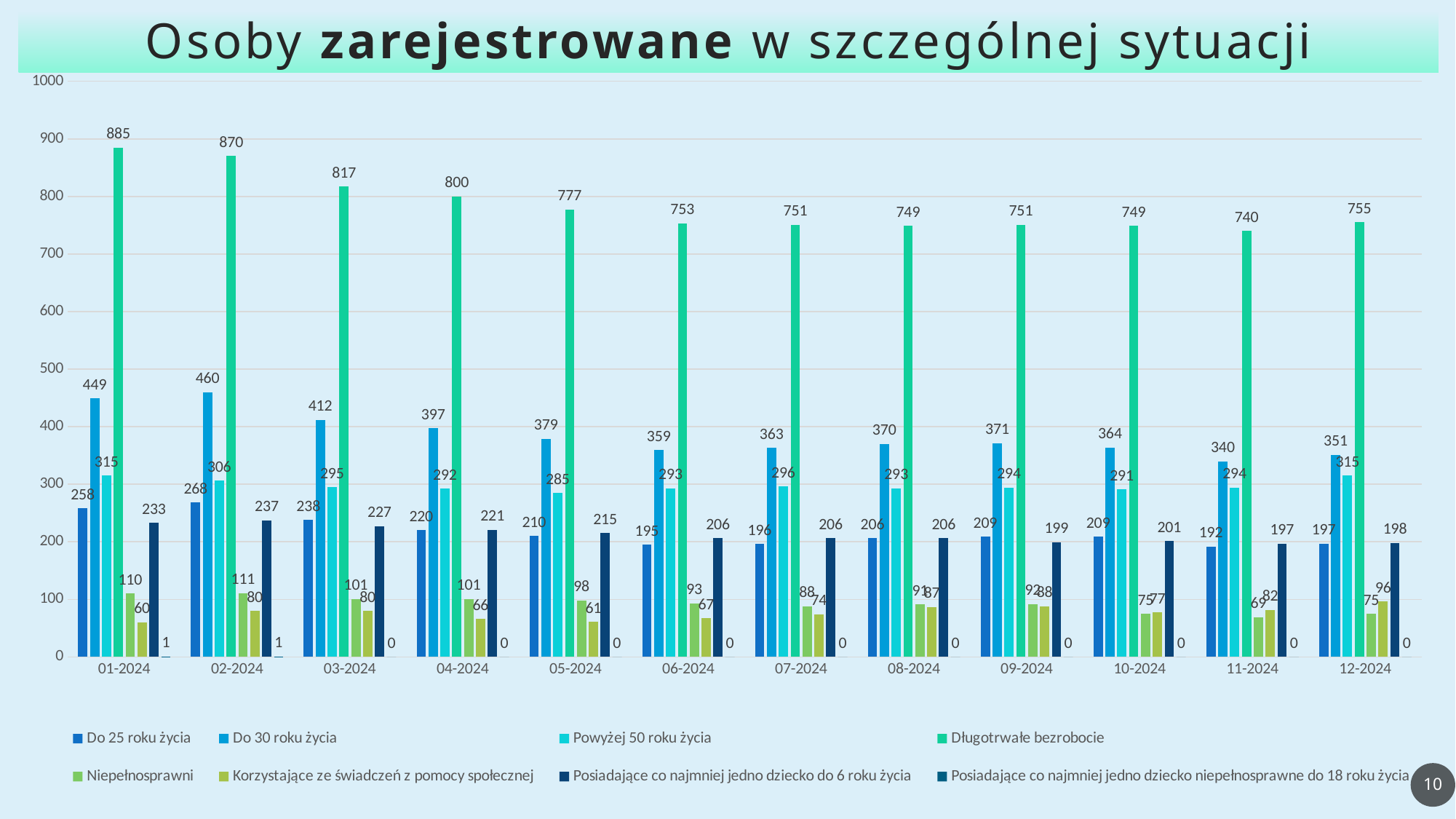
What is the value for Długotrwałe bezrobocie in 01-2024? 885 How many months are shown on the x axis? 12 Does the value for Do 25 roku życia rise or fall from 02-2024 to 06-2024? fall Which is larger: Do 30 roku życia in 03-2024 or Do 30 roku życia in 04-2024? 03-2024 In which month is the value for Długotrwałe bezrobocie the highest? 01-2024 What is the value for Do 30 roku życia in 02-2024? 460 How many series does the legend list? 8 What is the value for Posiadające co najmniej jedno dziecko do 6 roku życia in 12-2024? 198 Is the value for Do 30 roku życia in 05-2024 greater or less than 400? less What is the difference between the Długotrwałe bezrobocie values in 01-2024 and 12-2024? 130 In which month is the value for Do 25 roku życia the lowest? 11-2024 What kind of chart is shown on the slide? bar chart